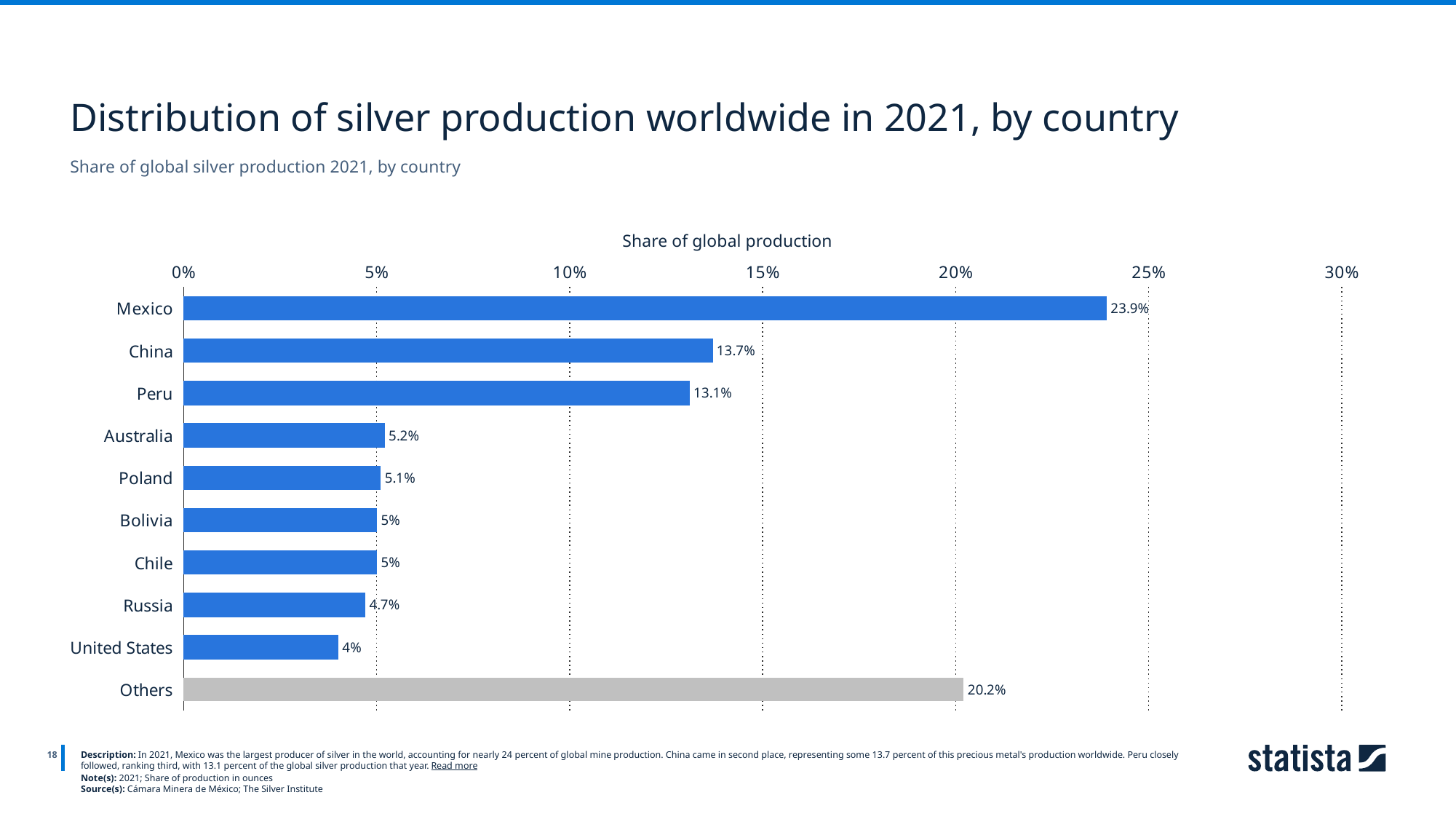
What is the value shown for Peru? 13.1% Is the value for Others greater or less than 20%? greater Which country has the highest share of global silver production on the chart? Mexico What kind of chart is shown on the slide? Bar chart What is the difference between Mexico's share and China's share? 10.2% Which has a larger share of global silver production, Australia or Russia? Australia What share of global silver production did Mexico account for in 2021? 23.9% How many categories are shown on the chart? 10 Which bar is coloured grey instead of blue? Others What share of global production is shown for the United States? 4% Which named country has the lowest share of global silver production on the chart? United States What is the title of the chart's value axis? Share of global production